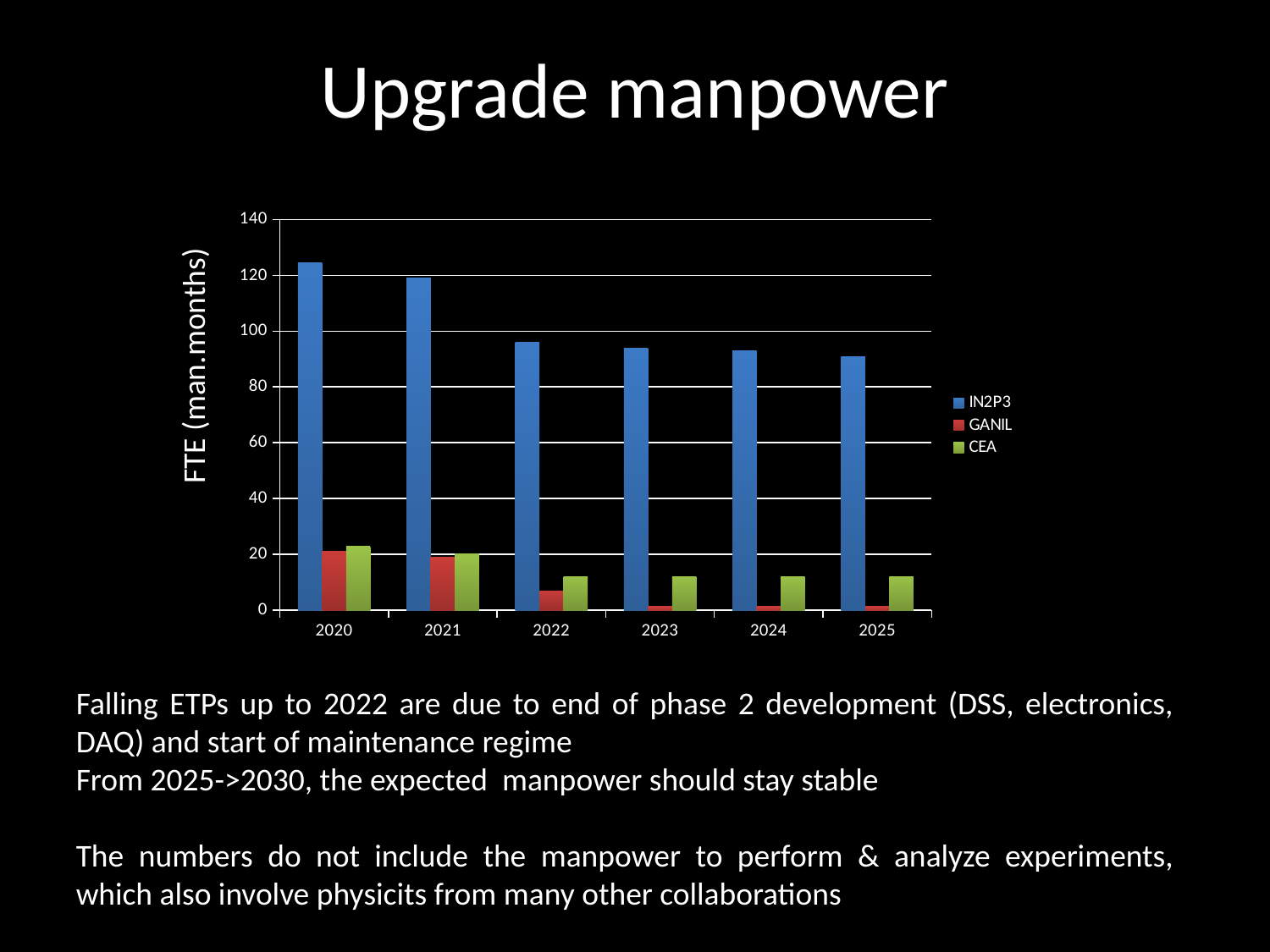
How many years are shown on the x axis? 6 What is the label on the y axis? FTE (man.months) What kind of chart is shown on the slide? bar chart Which year has the highest IN2P3 value? 2020 Do the IN2P3 values rise or fall from 2020 to 2025? fall How many series does the legend list? 3 Is the CEA value for 2023 greater or less than 20? less Which is larger, the IN2P3 value for 2020 or for 2022? 2020 In 2023, which is larger, the GANIL value or the CEA value? CEA Which year has the highest CEA value? 2020 Is the IN2P3 value for 2020 greater or less than 120? greater Is the IN2P3 value for 2022 greater or less than 100? less